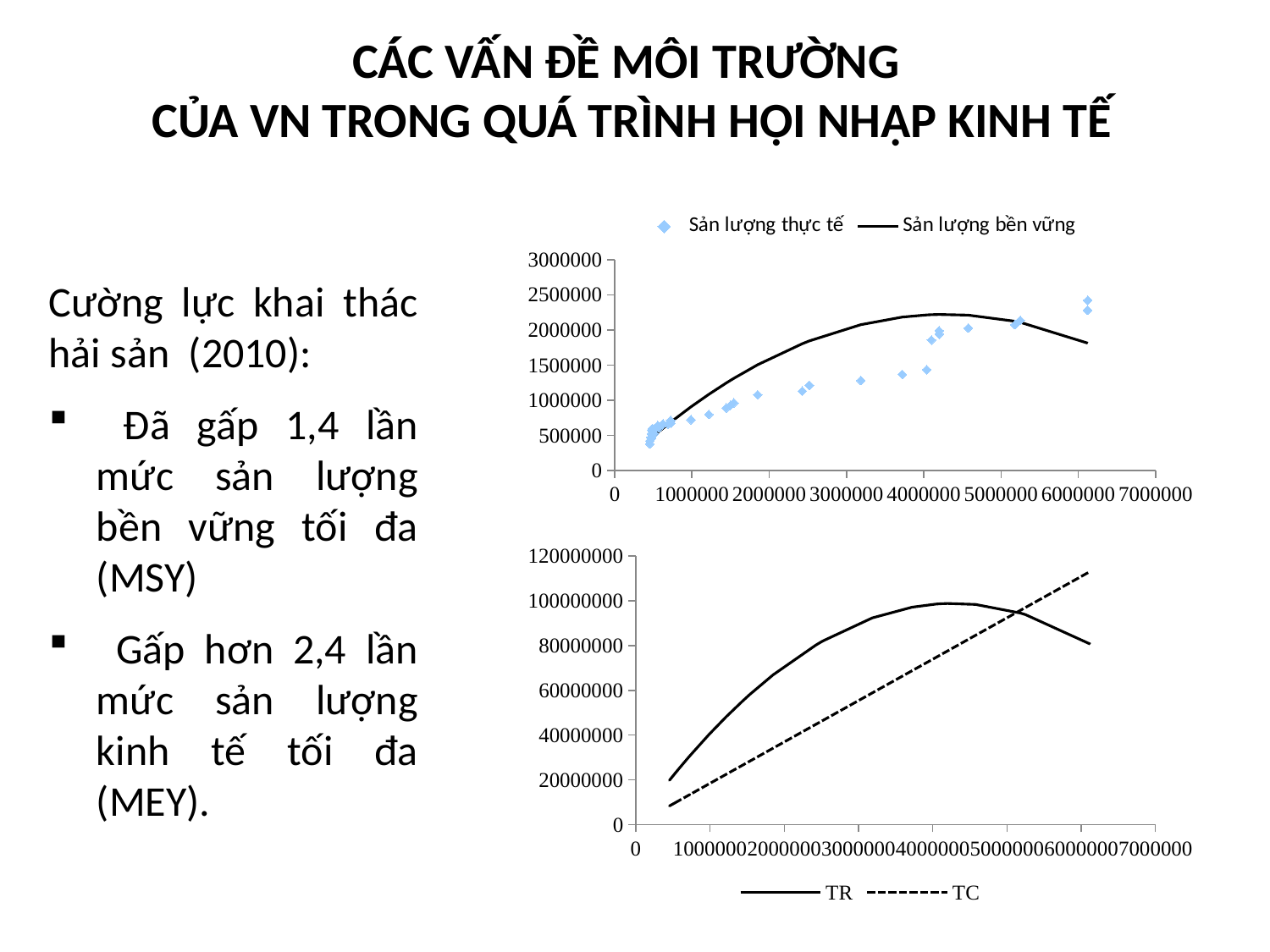
In the bottom chart, at x = 2000000, which series has the larger value, TR or TC? TR What kind of chart is the bottom chart? line chart In the top chart, is the peak value of the Sản lượng bền vững curve greater or less than 2000000? greater In the top chart, how many series does the legend list? 2 In the top chart, which series is shown as scattered diamond markers rather than a line? Sản lượng thực tế In the bottom chart, at x = 6000000, which series has the larger value, TR or TC? TC In the bottom chart, which series is drawn with a dashed line? TC In the bottom chart, does the TC line rise or fall as you move along the x axis? rise In the bottom chart, does the TR line rise steadily, fall steadily, or rise and then fall along the x axis? rise and then fall In the bottom chart, is the value of TC at x = 6000000 greater or less than 100000000? greater In the bottom chart, how many series does the legend list? 2